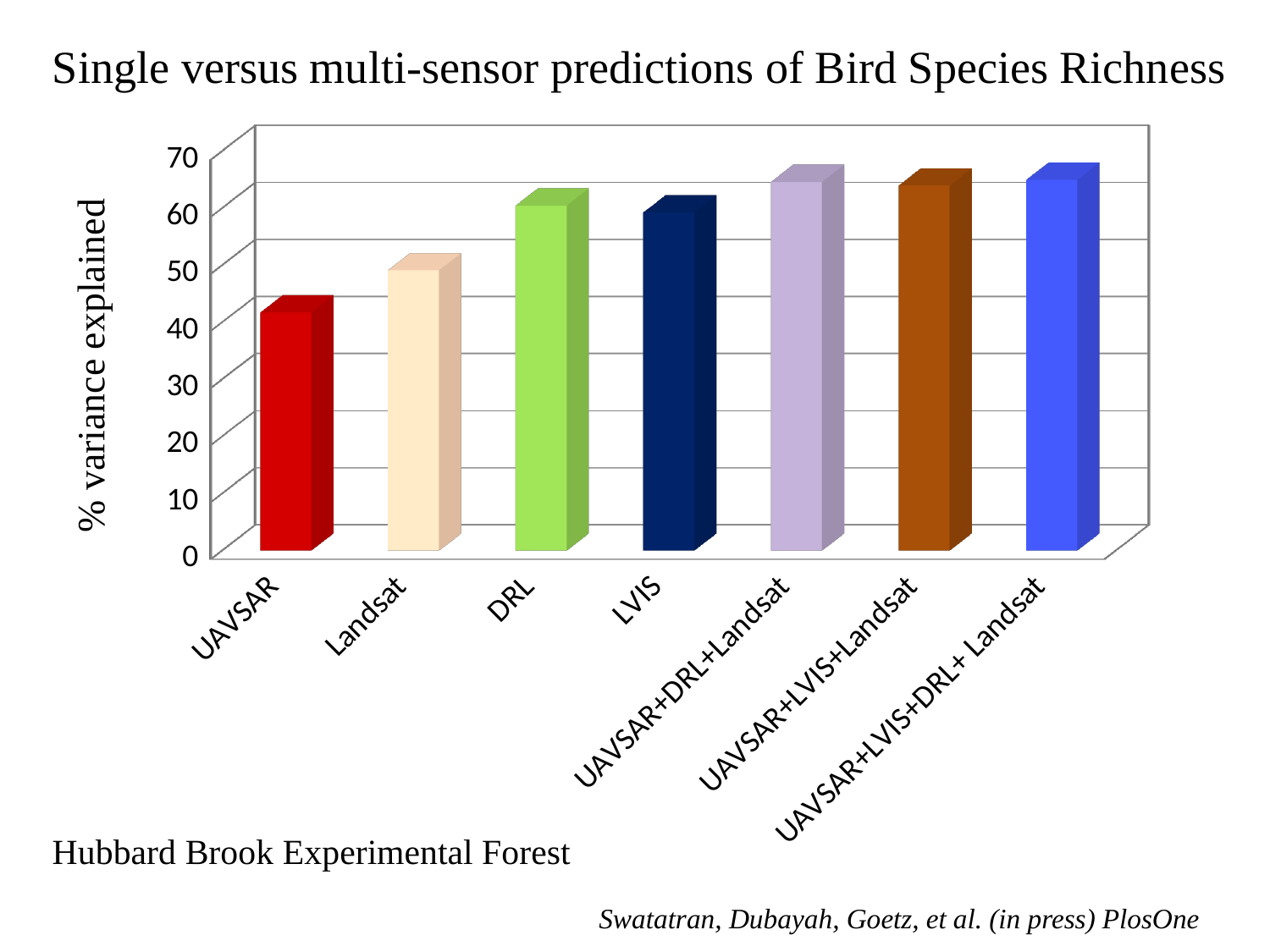
How many categories (bars) are plotted in the chart? 7 Is the value for Landsat greater or less than 40? greater Is the value for DRL greater or less than 50? greater What kind of chart is shown on the slide? bar chart What is the label of the vertical axis? % variance explained Which has a higher % variance explained, UAVSAR+DRL+Landsat or UAVSAR? UAVSAR+DRL+Landsat Which has a higher % variance explained, Landsat or UAVSAR? Landsat Is the value for UAVSAR greater or less than 50? less Which has a higher % variance explained, DRL or Landsat? DRL Which category has the lowest % variance explained? UAVSAR What is the title of the chart? Single versus multi-sensor predictions of Bird Species Richness